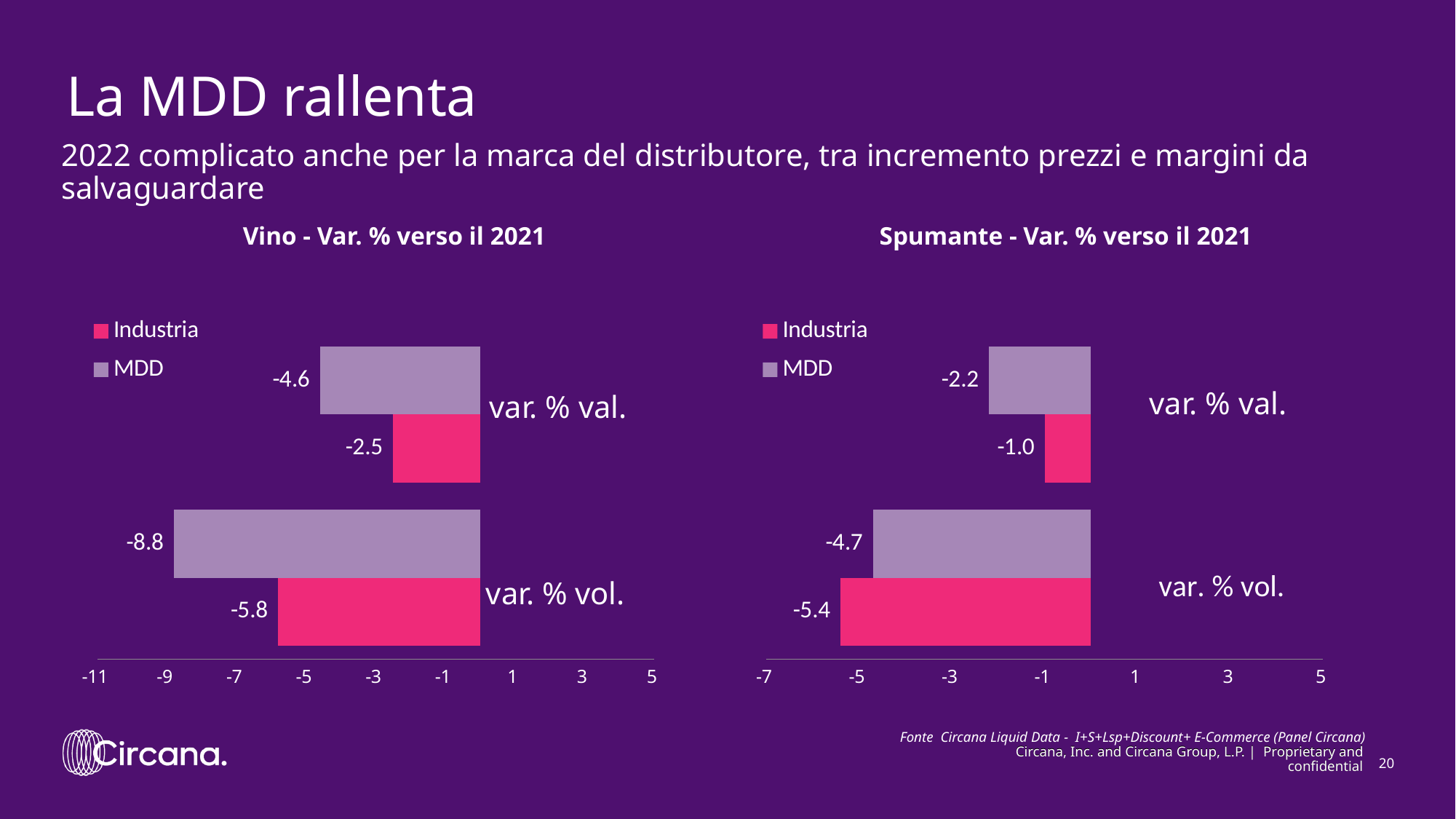
In the 'Spumante - Var. % verso il 2021' chart, what is the difference between the MDD and Industria values for var. % val.? 1.2 In the 'Vino - Var. % verso il 2021' chart, what is the value for Industria in var. % vol.? -5.8 How many series does the legend of the 'Spumante - Var. % verso il 2021' chart list? 2 In the 'Vino - Var. % verso il 2021' chart, what is the value for MDD in var. % val.? -4.6 In the 'Vino - Var. % verso il 2021' chart, what colour are the Industria bars? Pink In the 'Spumante - Var. % verso il 2021' chart, what is the value for MDD in var. % vol.? -4.7 In the 'Spumante - Var. % verso il 2021' chart, what is the value for Industria in var. % val.? -1.0 In the 'Vino - Var. % verso il 2021' chart, which bar has the lowest value? MDD, var. % vol. In the 'Vino - Var. % verso il 2021' chart, which series has the lower value for var. % val., Industria or MDD? MDD In the 'Spumante - Var. % verso il 2021' chart, which series has the lower value for var. % vol., Industria or MDD? Industria What kind of chart is the 'Vino - Var. % verso il 2021' chart? Bar chart In the 'Vino - Var. % verso il 2021' chart, what is the difference between the MDD and Industria values for var. % vol.? 3.0